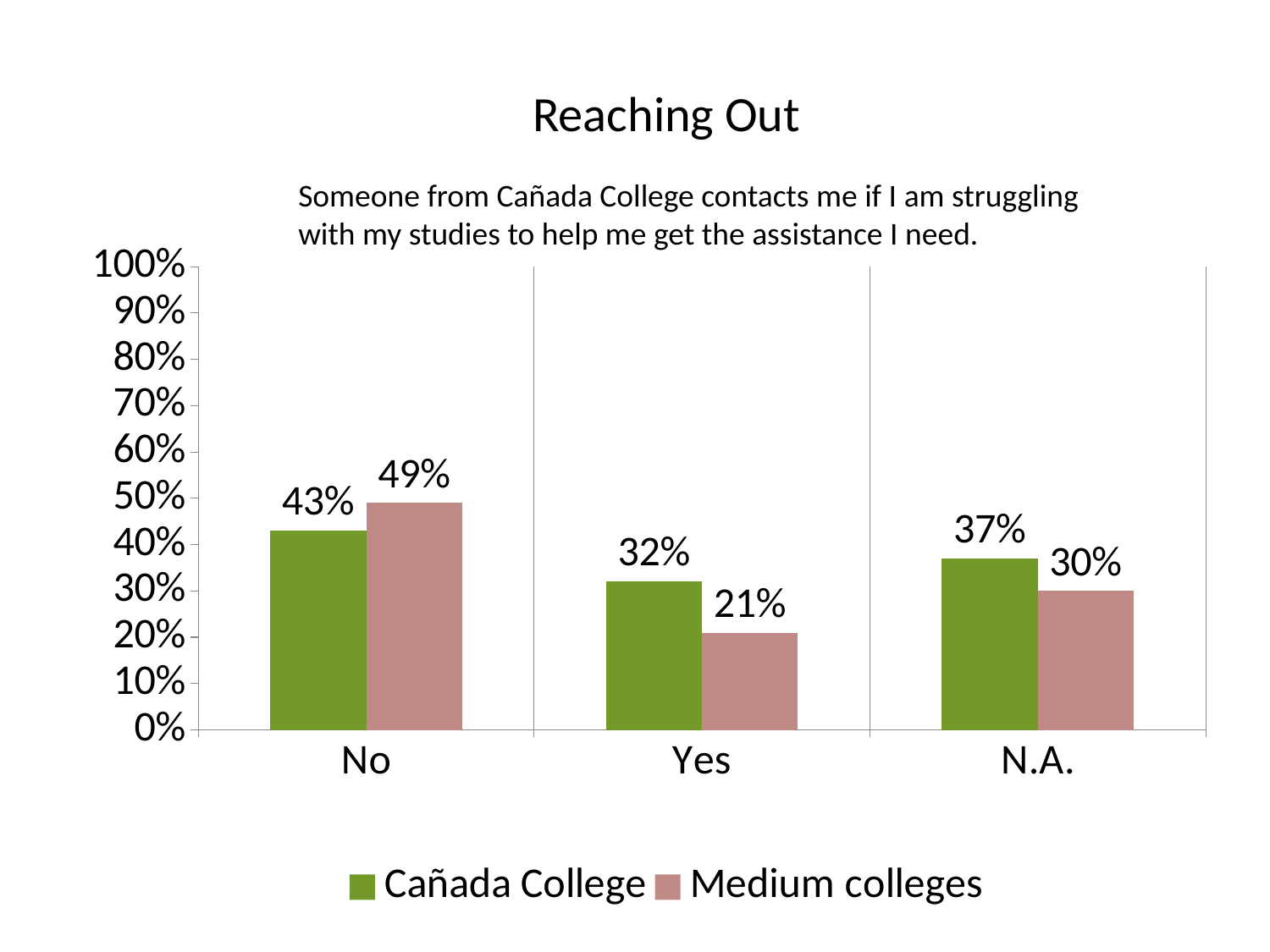
What is the difference between Medium colleges and Cañada College in the No category? 6% What kind of chart is shown on the slide? bar chart In the N.A. category, which series has the larger value, Cañada College or Medium colleges? Cañada College How many series does the legend list? 2 Which category has the lowest value for Cañada College? Yes What is the value for Medium colleges in the N.A. category? 30% What is the value for Medium colleges in the Yes category? 21% How many categories are shown on the x axis? 3 Which category has the highest value for Medium colleges? No Is the value for Medium colleges in the No category greater or less than 40%? greater What is the value for Cañada College in the No category? 43% What is the difference between Cañada College and Medium colleges in the Yes category? 11%